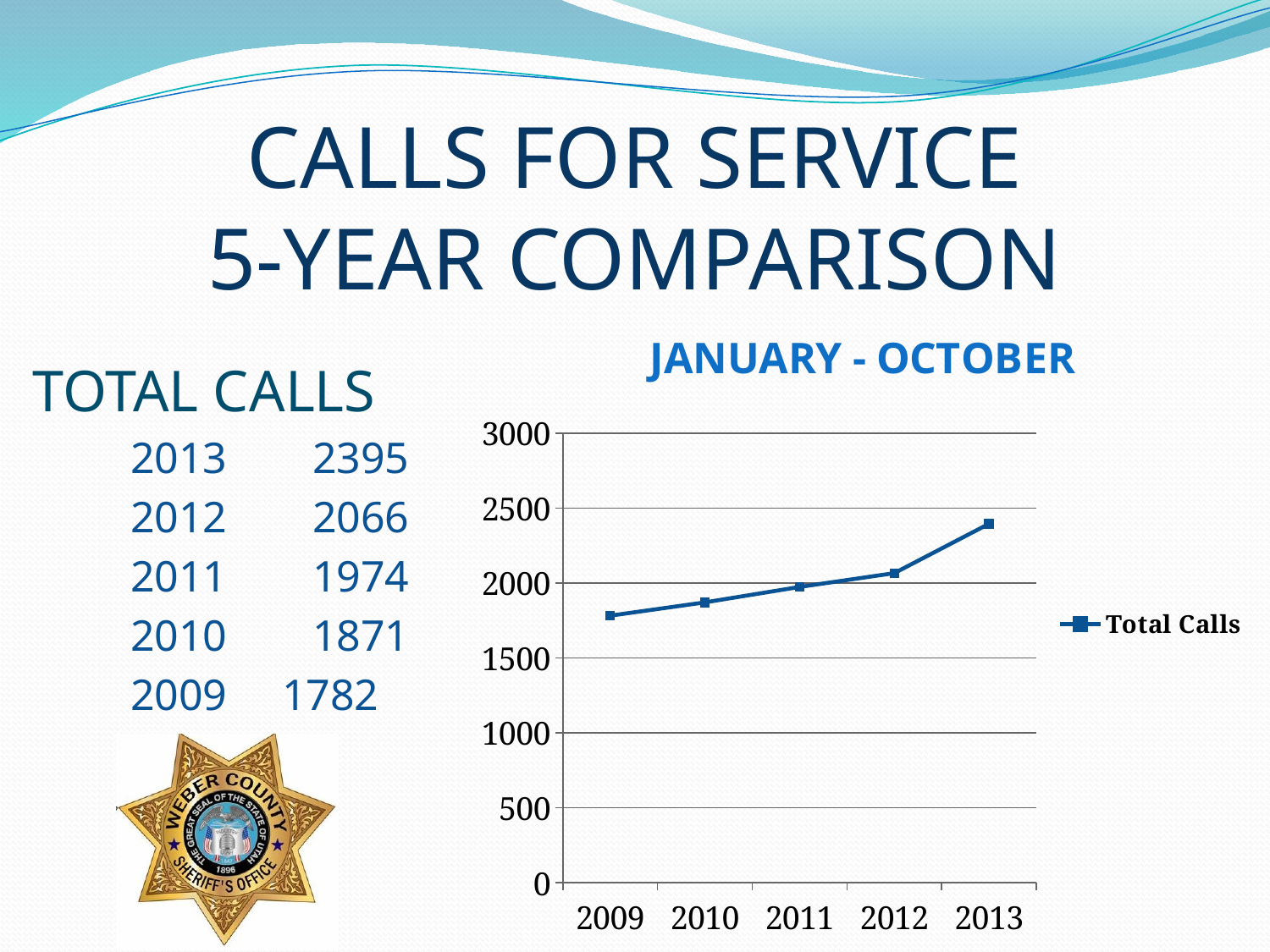
What is the name of the series shown in the chart legend? Total Calls Do total calls rise or fall from 2009 to 2013? rise What is the total calls value for 2013? 2395 Is the value for 2011 greater or less than 2000? less What is the difference in total calls between 2013 and 2012? 329 How many series does the chart legend list? 1 What is the title shown above the chart? JANUARY - OCTOBER Which year has the lowest number of total calls? 2009 How many years are plotted on the x axis of the chart? 5 What is the total calls value for 2009? 1782 What kind of chart is shown on the slide? line chart Which year has the highest number of total calls? 2013